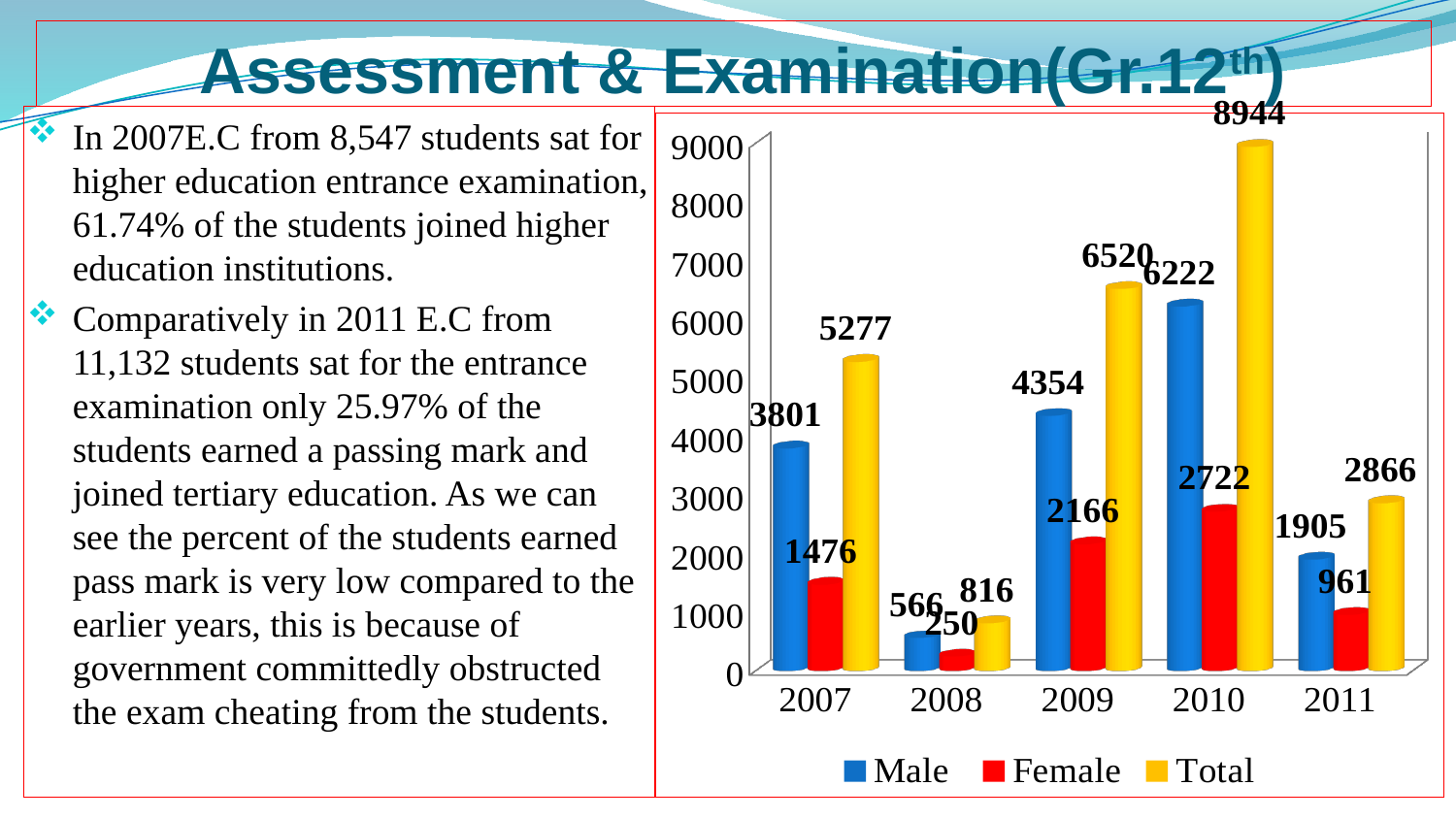
Which year has the highest Total value? 2010 What is the Male value for 2010? 6222 What is the Total value for 2007? 5277 Which colour represents the Female series in the chart? red How many years are shown on the x axis? 5 Is the Total value for 2011 greater or less than 3000? less Which is larger, the Male value for 2009 or the Male value for 2007? Male value for 2009 What is the Female value for 2009? 2166 How many series does the legend list? 3 What kind of chart is shown on the slide? bar chart What is the difference between the Male and Female values in 2011? 944 Which year has the lowest Female value? 2008